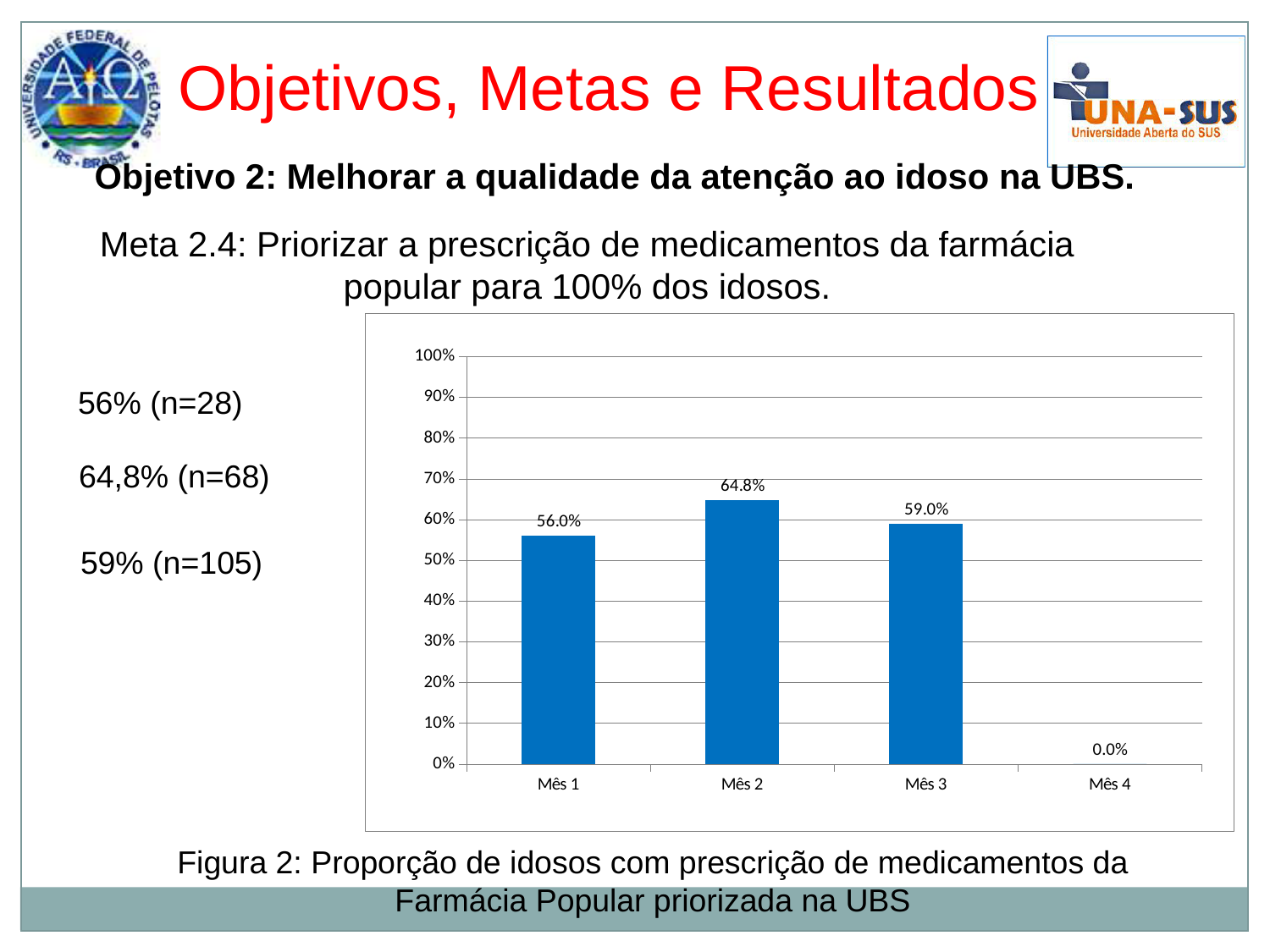
What is the value for Mês 1? 56.0% Is the value for Mês 2 greater or less than 60%? greater What is the difference between the values for Mês 2 and Mês 1? 8.8% Which month has the lowest value? Mês 4 What kind of chart is shown? bar chart How many months are shown on the x axis? 4 What is the maximum value shown on the y axis? 100% Which is larger, the value for Mês 3 or the value for Mês 1? Mês 3 What is the value for Mês 3? 59.0% What is the value for Mês 2? 64.8% What is the value for Mês 4? 0.0% Which month has the highest value? Mês 2